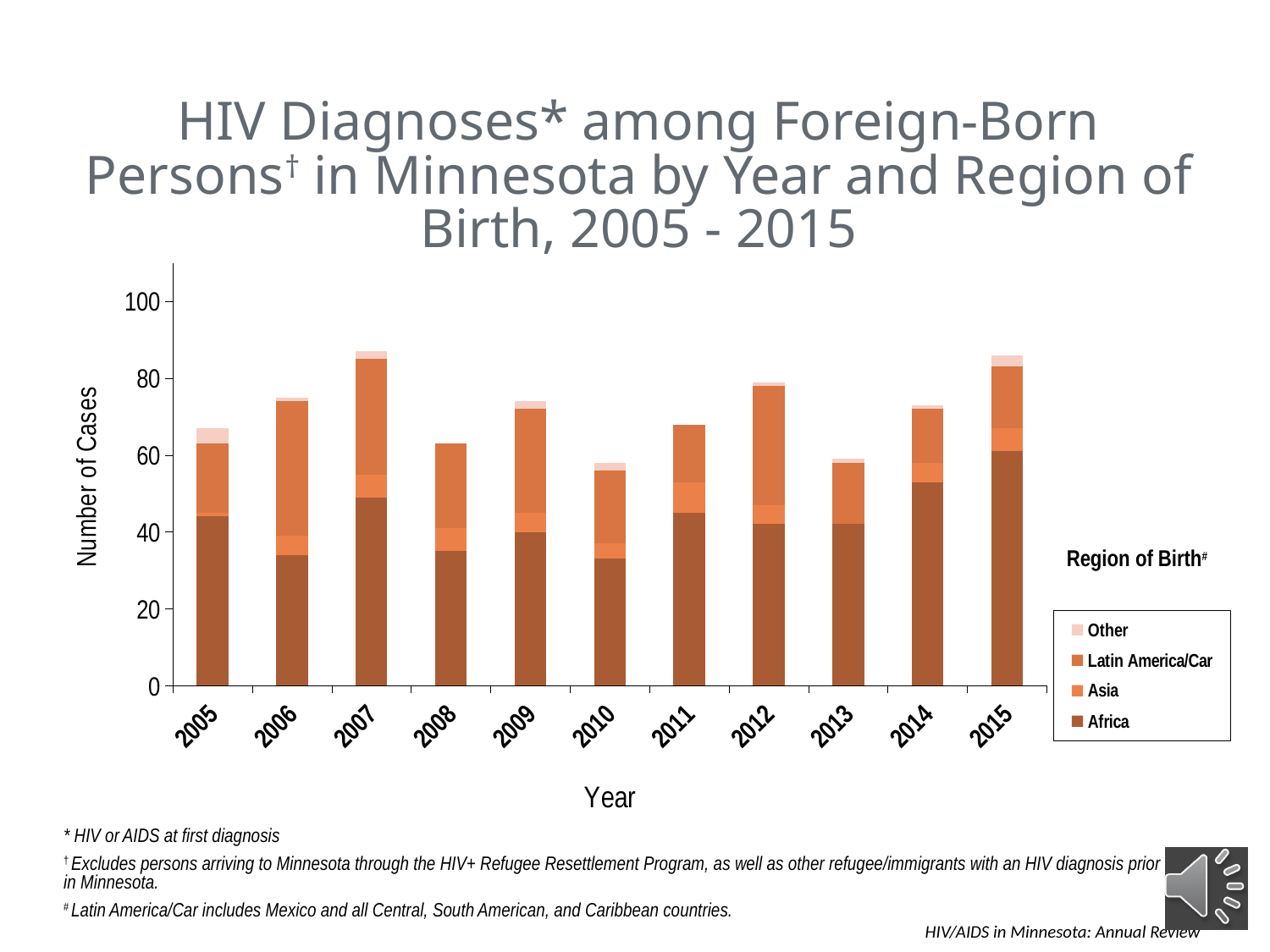
How many regions of birth does the legend list? 4 Which year has the larger total number of cases, 2007 or 2010? 2007 Is the total number of cases for 2007 greater or less than 80? greater Which year has the larger total number of cases, 2011 or 2012? 2012 Is the total number of cases for 2010 greater or less than 60? less Is the number of cases for Africa in 2006 greater or less than 40? less In which year is the Africa segment the tallest? 2015 How many years are shown along the x axis of the chart? 11 What kind of chart is shown on the slide? Stacked bar chart What is the label of the y axis? Number of Cases